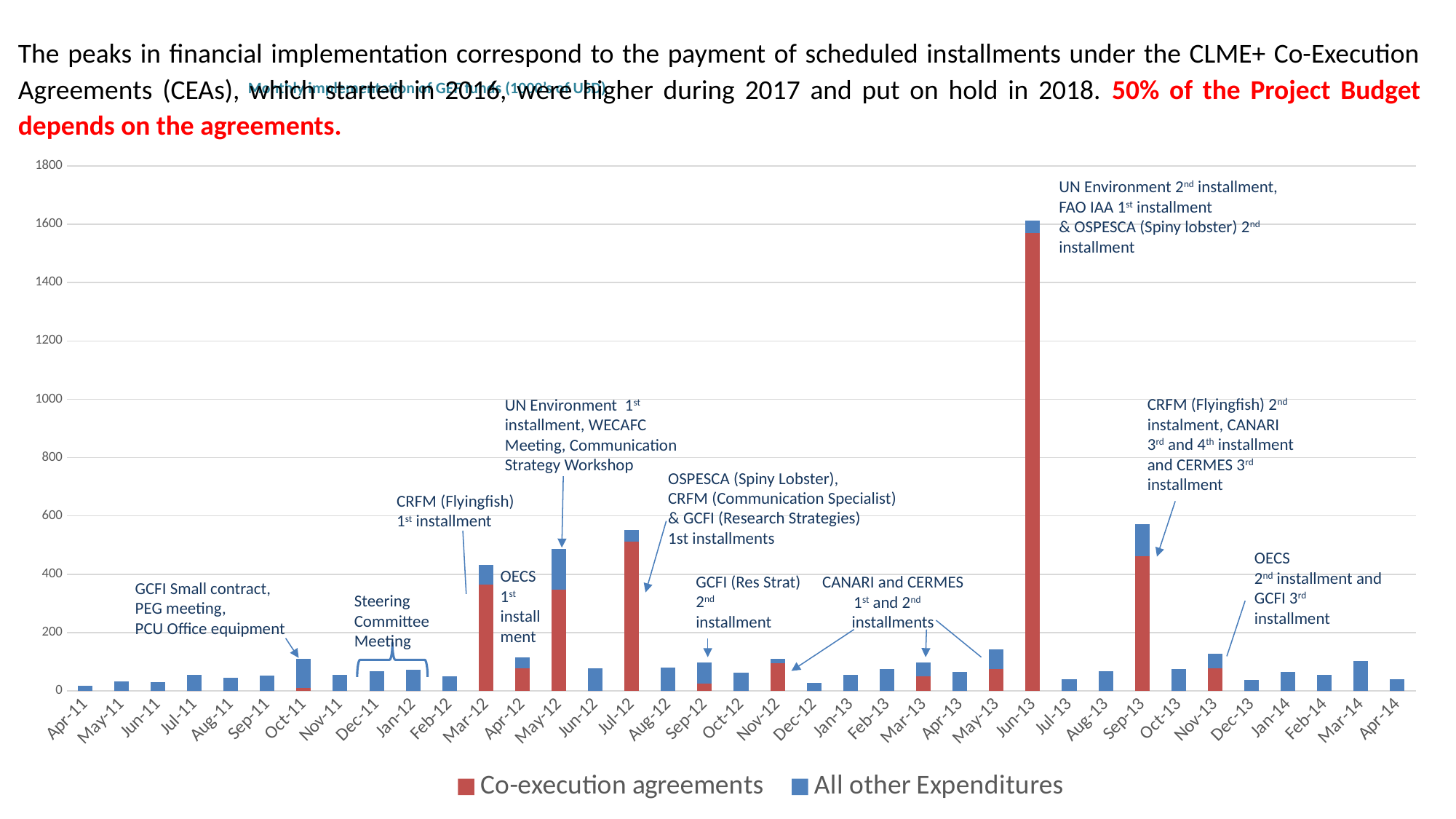
Is the total value for Jul-12 greater or less than 400? greater Which two months are annotated with 'Steering Committee Meeting'? Dec-11 and Jan-12 Which has the larger total bar, Jun-13 or Sep-13? Jun-13 Is the total value for Sep-13 greater or less than 400? greater Which has the larger total bar, Mar-12 or Apr-12? Mar-12 What kind of chart is shown on the slide? Stacked bar chart Is the total value for Dec-12 greater or less than 200? less Which colour represents the 'Co-execution agreements' series in the legend? Red Which month has the highest total bar in the chart? Jun-13 How many months (categories) are plotted along the x axis? 37 How many series does the chart legend list? 2